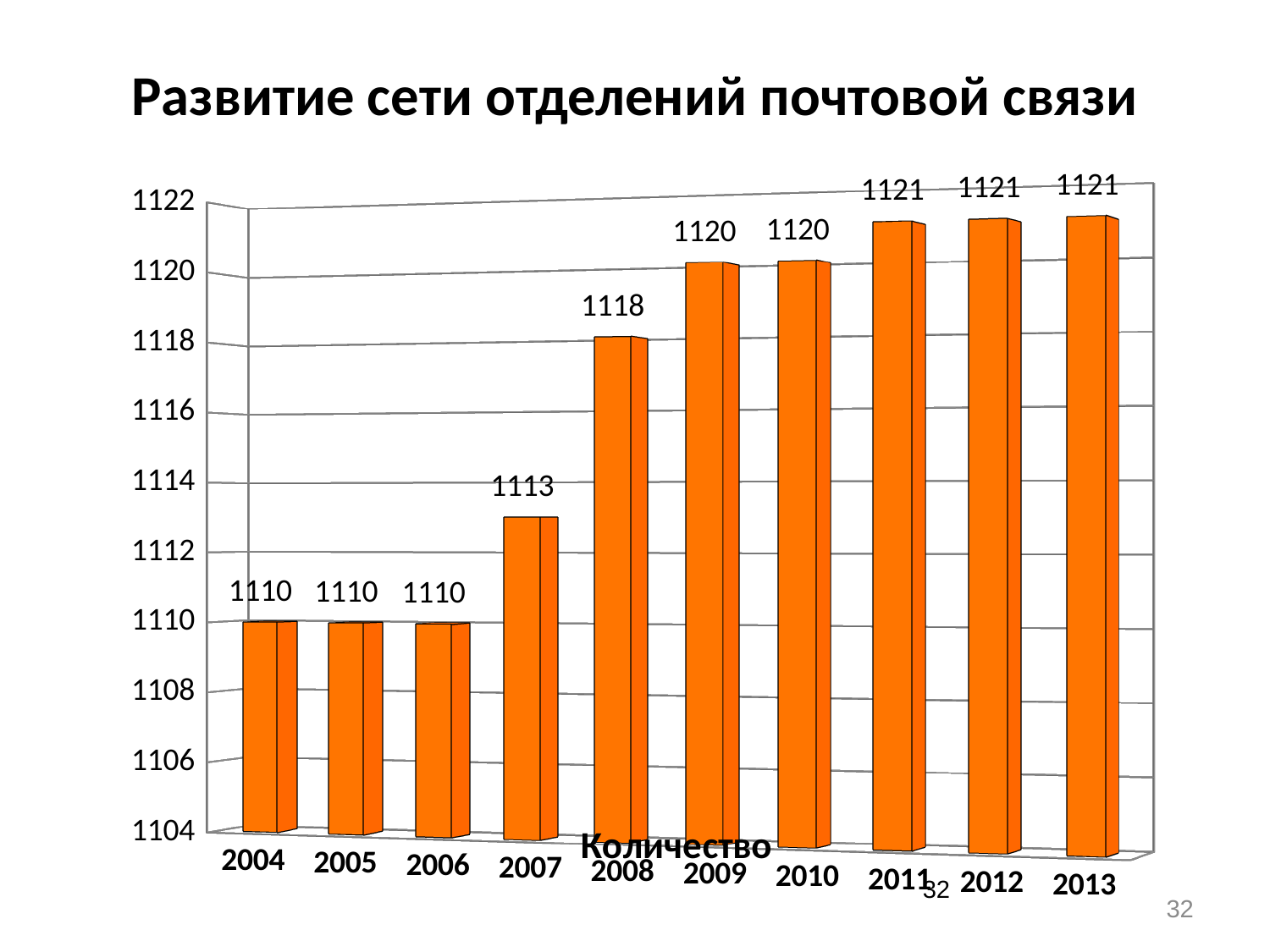
Do the values generally rise or fall from 2004 to 2013? Rise What is the value for 2004? 1110 Is the value for 2009 greater than the value for 2008? Yes What kind of chart is shown on the slide? Bar chart What is the difference between the values for 2013 and 2004? 11 What is the value for 2013? 1121 How many years are shown on the x axis? 10 What is the value for 2007? 1113 What is the value for 2008? 1118 Which year has the lowest value, 2005 or 2009? 2005 What is the title of the chart? Развитие сети отделений почтовой связи What is the difference between the values for 2008 and 2007? 5